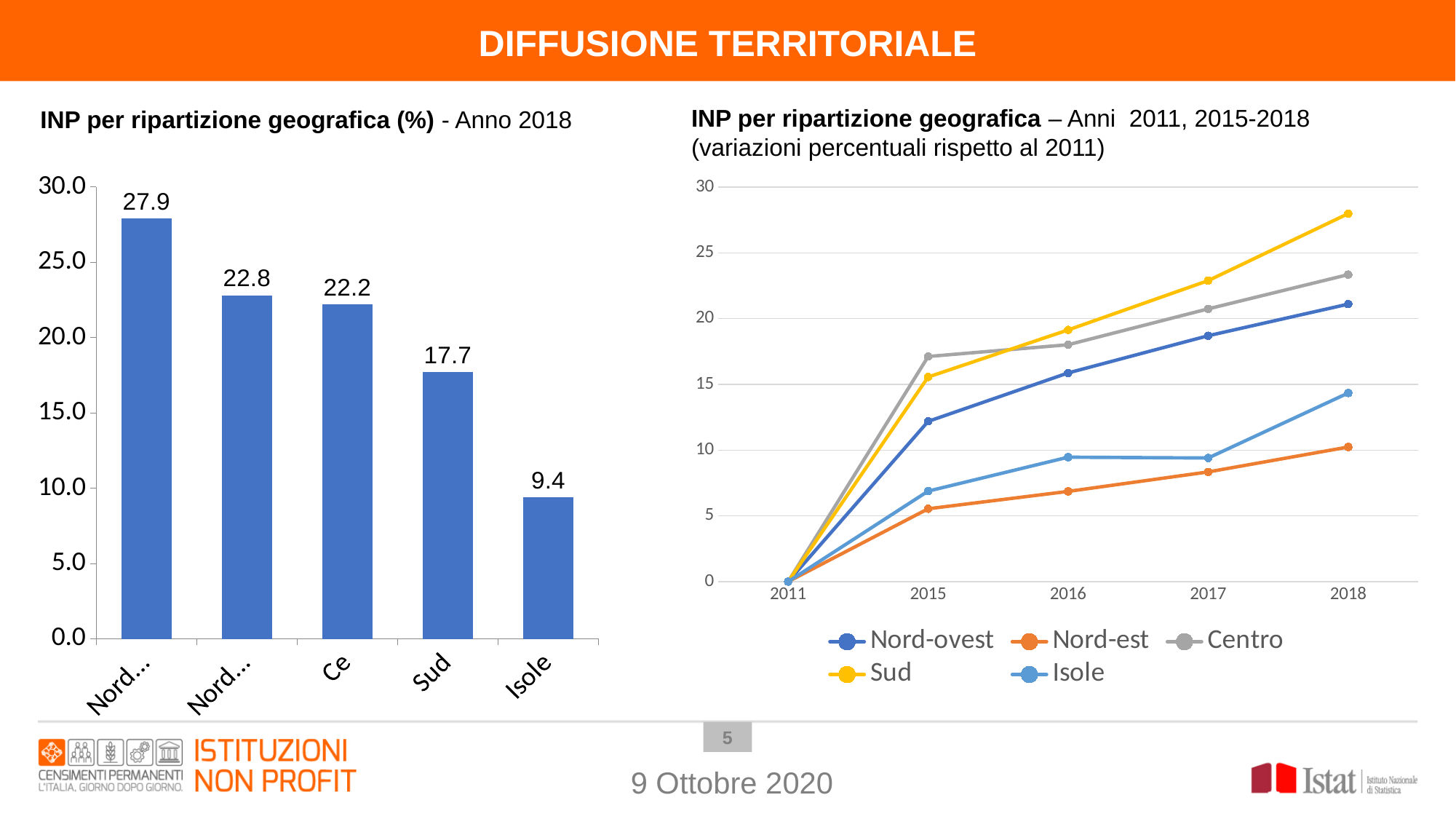
On the right line chart (variazioni percentuali rispetto al 2011), which series has the highest value in 2018? Sud What kind of chart is the left chart (INP per ripartizione geografica (%) - Anno 2018)? Bar chart On the right line chart (variazioni percentuali rispetto al 2011), how many series does the legend list? 5 On the left bar chart (INP per ripartizione geografica (%) - Anno 2018), what is the difference between the values for Sud and Isole? 8.3 On the left bar chart (INP per ripartizione geografica (%) - Anno 2018), which category has the lowest value? Isole On the right line chart (variazioni percentuali rispetto al 2011), is the value for Sud in 2018 greater or less than 25? greater On the left bar chart (INP per ripartizione geografica (%) - Anno 2018), what is the value for Sud? 17.7 On the left bar chart (INP per ripartizione geografica (%) - Anno 2018), how many bars are shown? 5 On the right line chart (variazioni percentuali rispetto al 2011), does the Sud series rise or fall from 2011 to 2018? Rise On the left bar chart (INP per ripartizione geografica (%) - Anno 2018), what is the value of the first bar from the left? 27.9 On the right line chart (variazioni percentuali rispetto al 2011), which series has the lowest value in 2018? Nord-est On the left bar chart (INP per ripartizione geografica (%) - Anno 2018), what is the value for Isole? 9.4